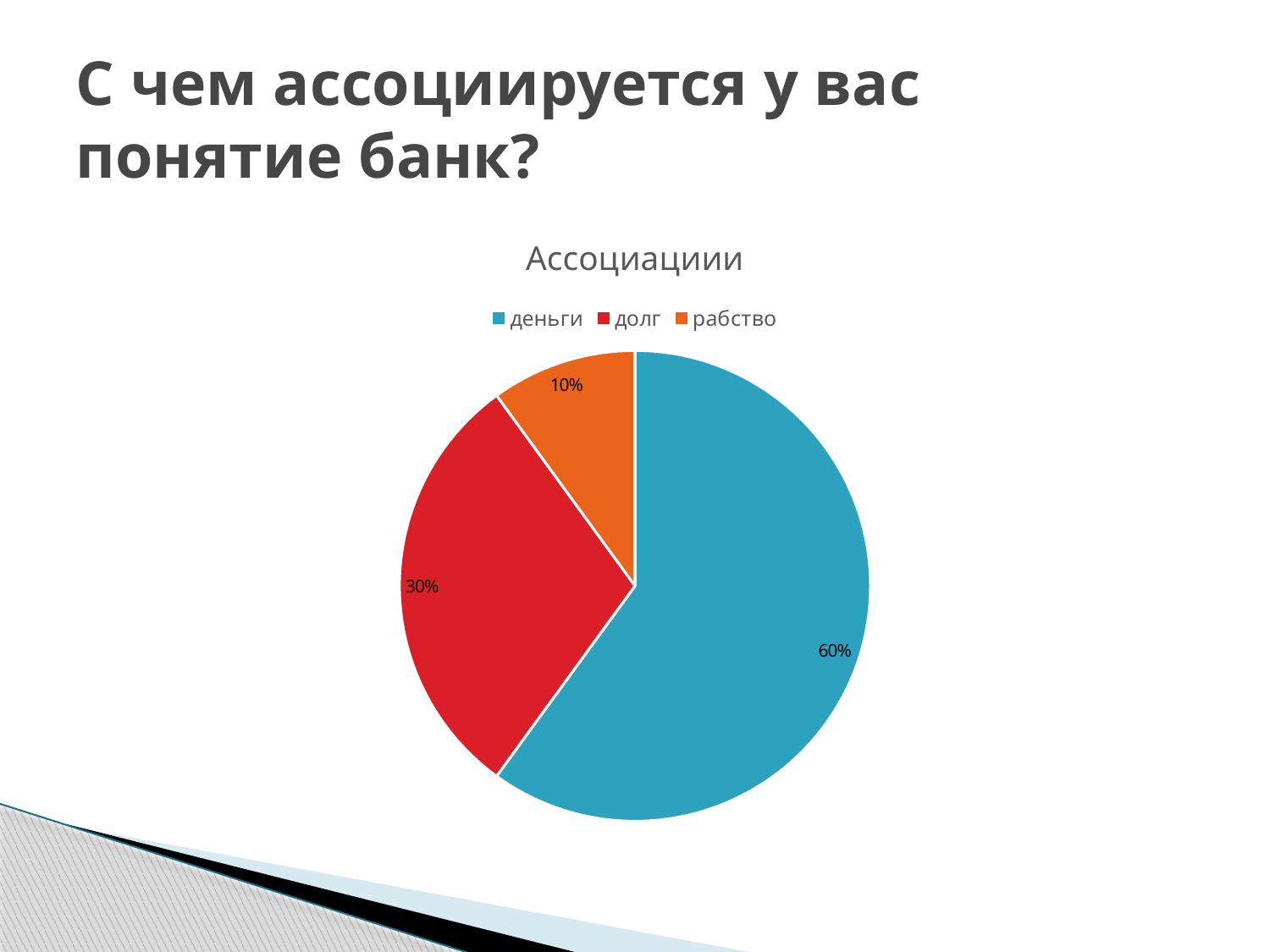
What share of the pie is labelled долг? 30% How many slices does the pie chart have? 3 Which category has the smallest slice? рабство What share of the pie is labelled рабство? 10% Which category has the largest slice? деньги What kind of chart is shown on the slide? pie chart How many entries does the legend list? 3 What share of the pie is labelled деньги? 60% Which is larger, the share for долг or the share for рабство? долг What is the chart's title? Ассоциациии What colour is the slice for долг? red What is the difference between the shares for деньги and долг? 30%